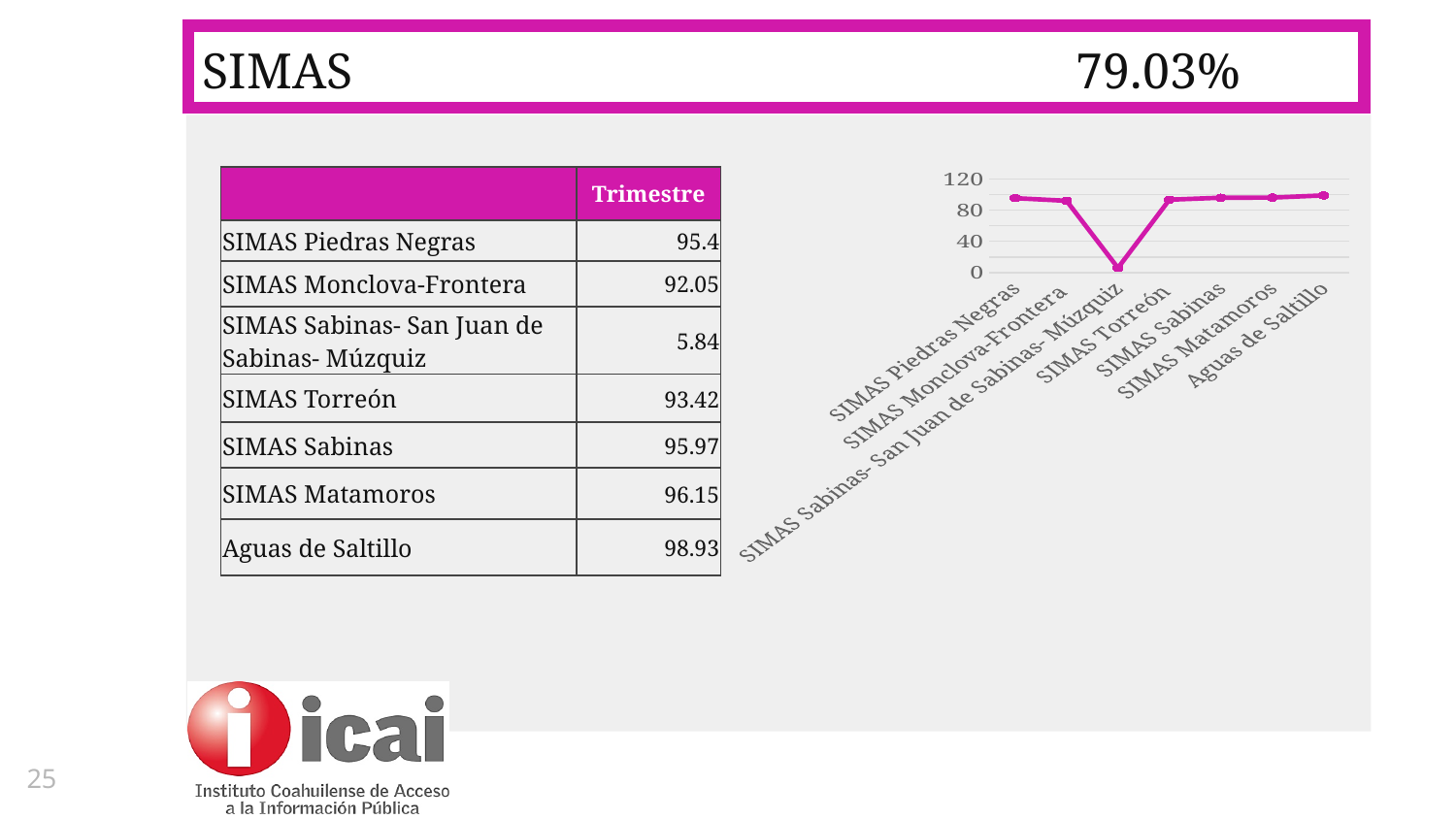
Which is larger, the value for SIMAS Piedras Negras or for SIMAS Moncloa-Frontera? SIMAS Piedras Negras How many categories are plotted along the x axis of the chart? 7 Is the value for Aguas de Saltillo greater or less than 120? less What is the Trimestre value for SIMAS Matamoros? 96.15 Is the value for SIMAS Torreón greater or less than 80? greater What kind of chart is shown on the slide? line chart What is the difference between the values for Aguas de Saltillo and SIMAS Sabinas- San Juan de Sabinas- Múzquiz? 93.09 What is the Trimestre value for SIMAS Piedras Negras? 95.4 Which category has the highest value in the chart? Aguas de Saltillo Which category has the lowest value in the chart? SIMAS Sabinas- San Juan de Sabinas- Múzquiz What is the highest tick value shown on the chart's vertical axis? 120 Is the value for SIMAS Sabinas- San Juan de Sabinas- Múzquiz greater or less than 40? less